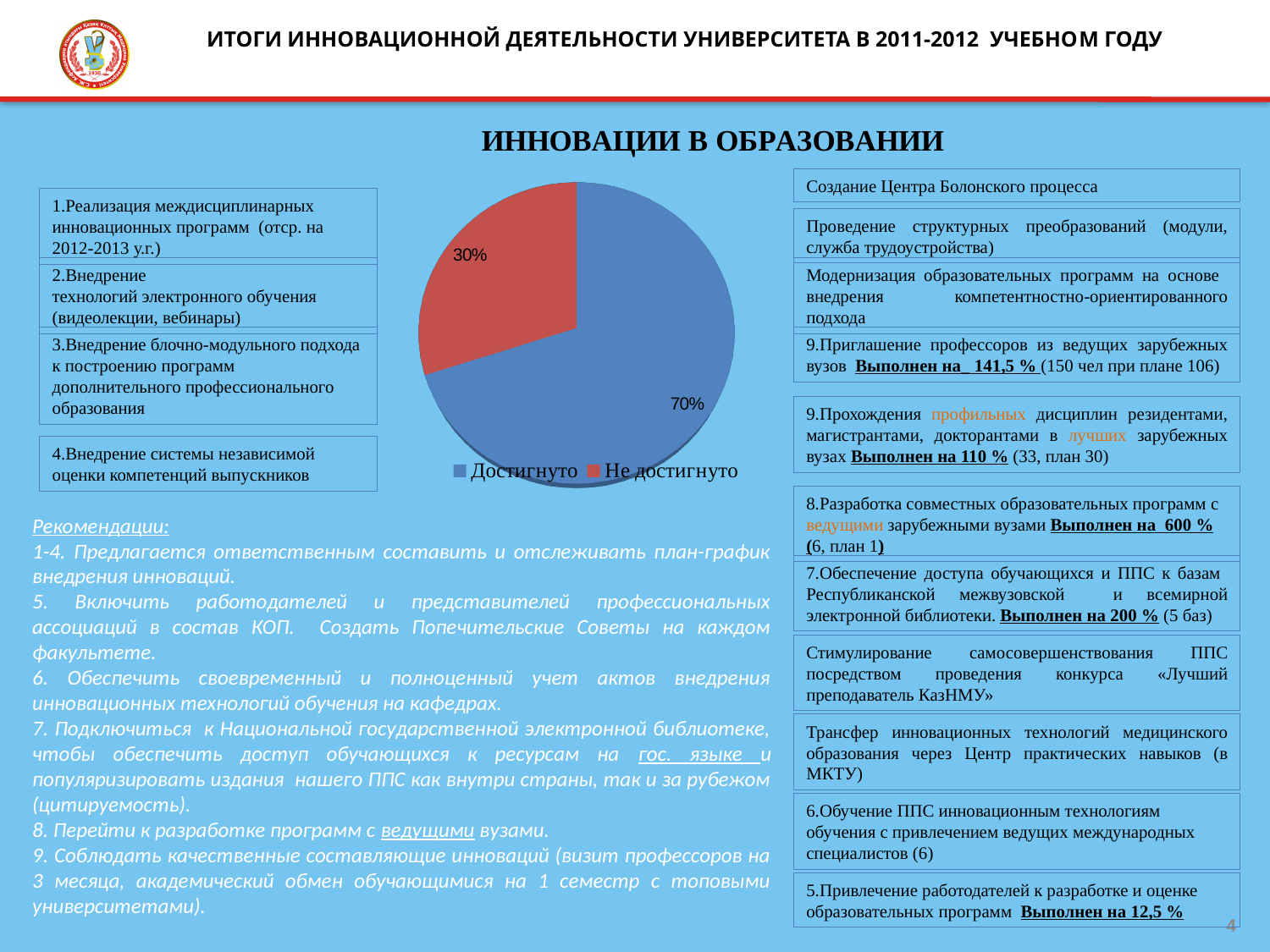
How many slices does the pie chart have? 2 Which slice of the pie chart is the smallest? Не достигнуто What colour is the "Не достигнуто" slice in the pie chart? red What kind of chart is shown on the slide? pie chart Which is larger in the pie chart, "Достигнуто" or "Не достигнуто"? Достигнуто What share of the pie does "Не достигнуто" represent? 30% What share of the pie does "Достигнуто" represent? 70% What colour is the "Достигнуто" slice in the pie chart? blue Which slice of the pie chart is the largest? Достигнуто What is the total of the two percentages shown in the pie chart? 100% How many entries does the legend of the pie chart list? 2 What is the difference in percentage points between the "Достигнуто" and "Не достигнуто" slices? 40